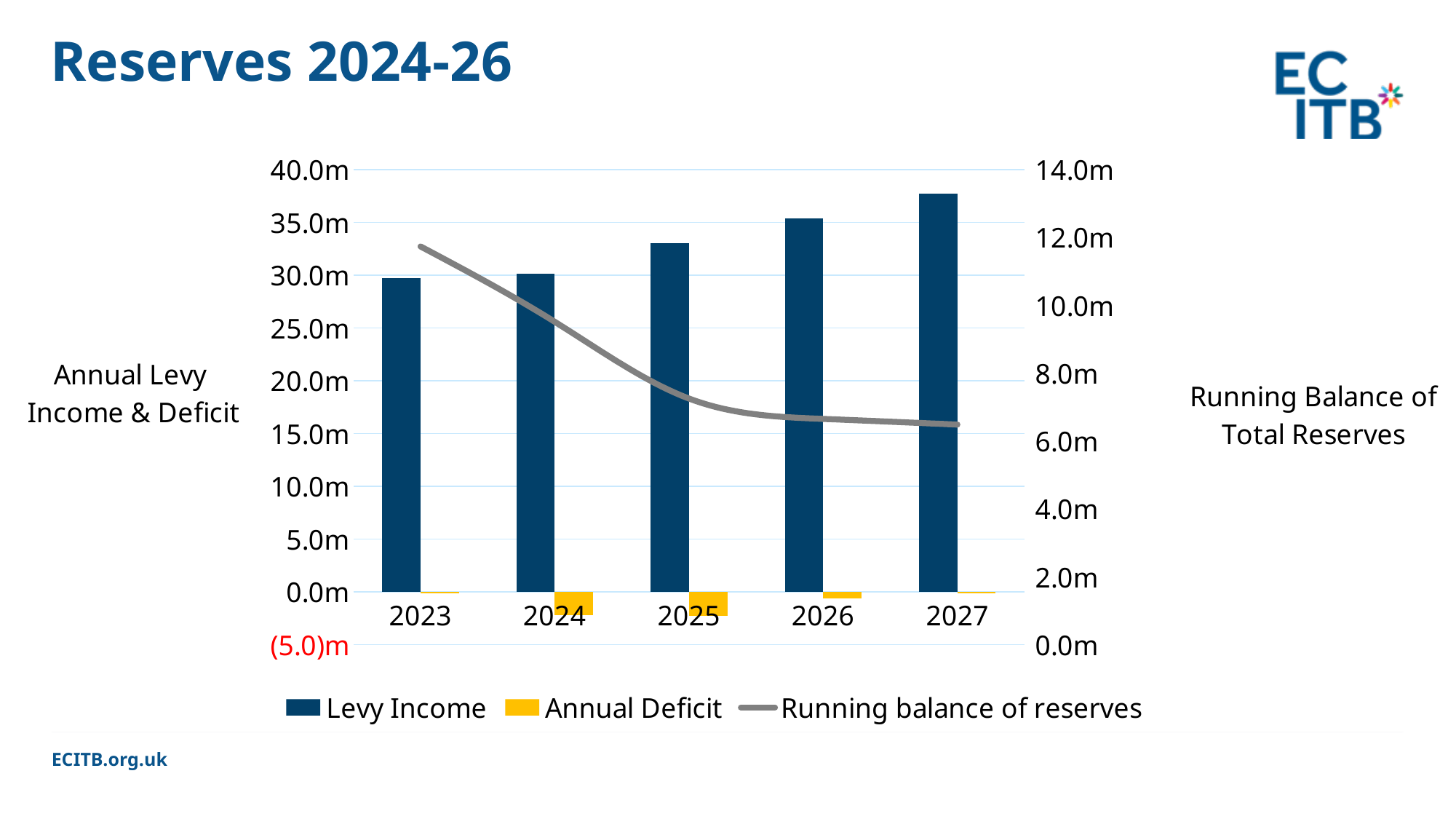
Does the Running balance of reserves line rise or fall from 2023 to 2027? It falls What kind of chart is shown on the slide? A combined bar and line chart Is the Levy Income value for 2025 greater or less than 30.0m? greater Is the Levy Income value for 2027 greater or less than 35.0m? greater How many years are shown on the x axis of the chart? 5 Which year has the highest Levy Income bar? 2027 Is the Running balance of reserves for 2023 greater or less than 10.0m on the right axis? greater What is the title of the slide containing the chart? Reserves 2024-26 How many series does the chart legend list? 3